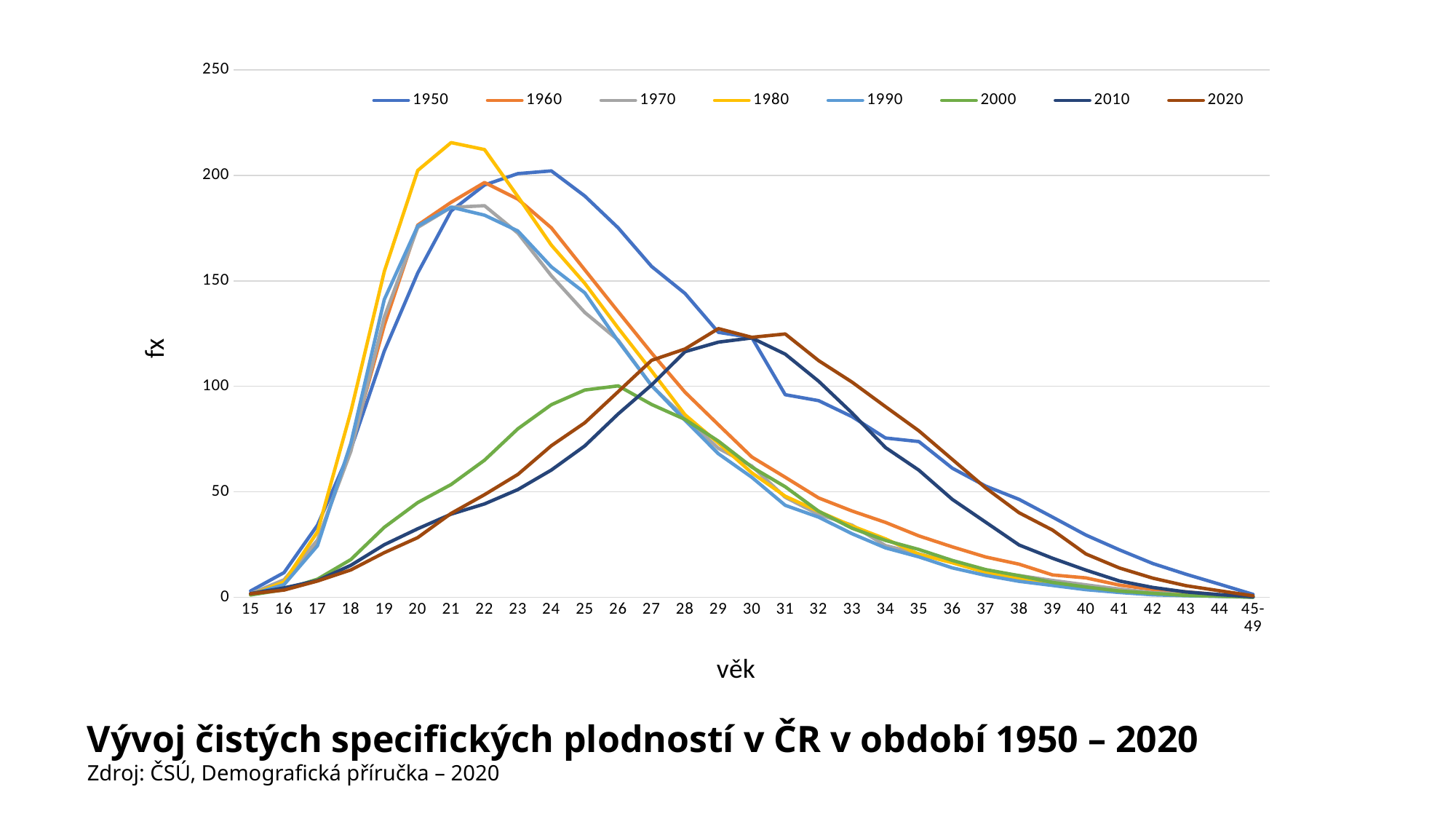
Is the value for the 1990 series at age 21 greater or less than 200? less How many series does the legend list? 8 Is the value for the 2020 series at age 40 greater or less than 50? less Is the value for the 1980 series at age 21 greater or less than 200? greater How many age categories are shown on the x axis? 31 What is the label of the x axis? věk Which series has the lowest peak value? 2000 At age 30, which series has the larger value, 2020 or 2000? 2020 Which series reaches the highest peak value? 1980 What kind of chart is shown on the slide? line chart Does the 1950 series rise or fall between age 24 and age 44? fall